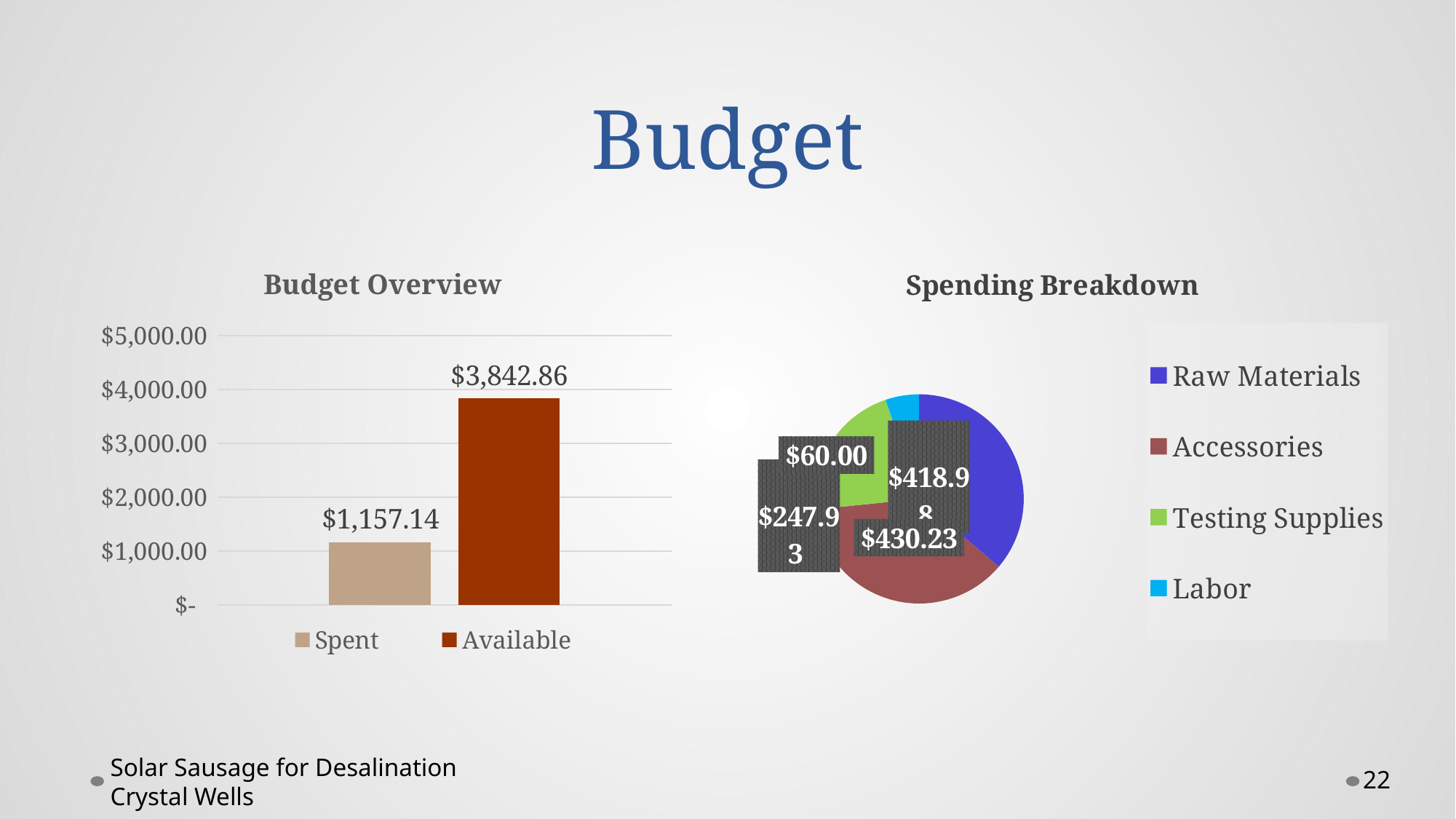
In the Budget Overview chart, what is the difference between Available and Spent? $2,685.72 In the Spending Breakdown chart, what is the value for Labor? $60.00 In the Budget Overview chart, is the value for Spent greater or less than $2,000.00? less How many categories does the legend of the Spending Breakdown chart list? 4 How many series does the legend of the Budget Overview chart list? 2 In the Budget Overview chart, what is the value for Available? $3,842.86 In the Budget Overview chart, which is larger, Spent or Available? Available In the Budget Overview chart, what is the value for Spent? $1,157.14 What kind of chart is the Budget Overview chart? bar chart What is the title of the chart on the left side of the slide? Budget Overview What kind of chart is the Spending Breakdown chart? pie chart In the Spending Breakdown chart, which category has the smallest slice? Labor